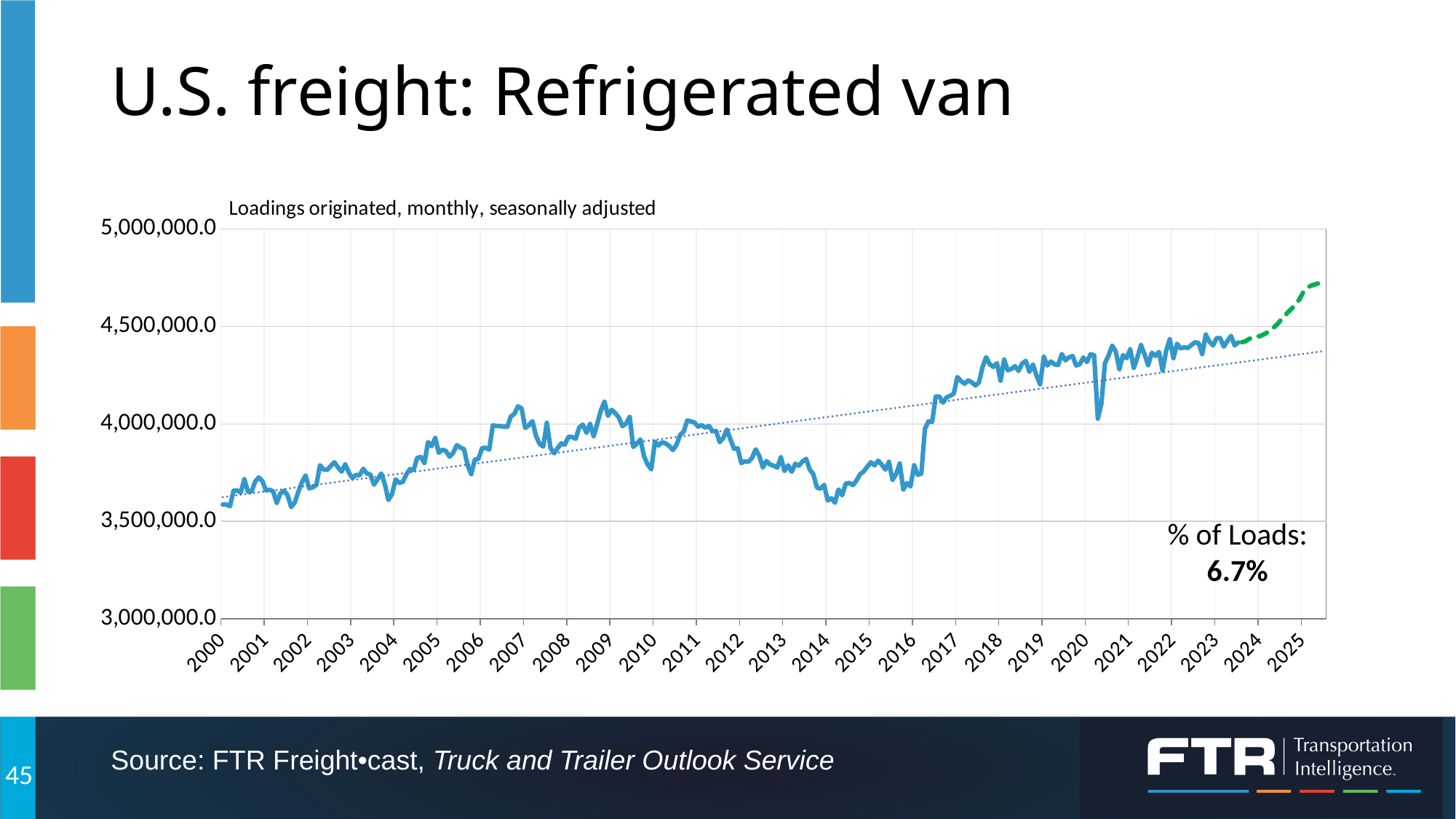
What is the title of the slide? U.S. freight: Refrigerated van Is the value at the start of 2000 greater or less than 3,500,000.0? greater Overall, do the loadings rise or fall from 2000 to 2025 along the x axis? rise Between 2009 and 2014, do the loadings generally rise or fall? fall Is the value in 2018 greater or less than 4,000,000.0? greater What does the subtitle above the chart say the plotted data is? Loadings originated, monthly, seasonally adjusted What percentage of loads is shown in the annotation on the chart? 6.7% Is the value at the end of the dashed line in 2025 greater or less than 4,500,000.0? greater What kind of chart is shown on the slide? line chart How many year labels are shown on the x axis? 26